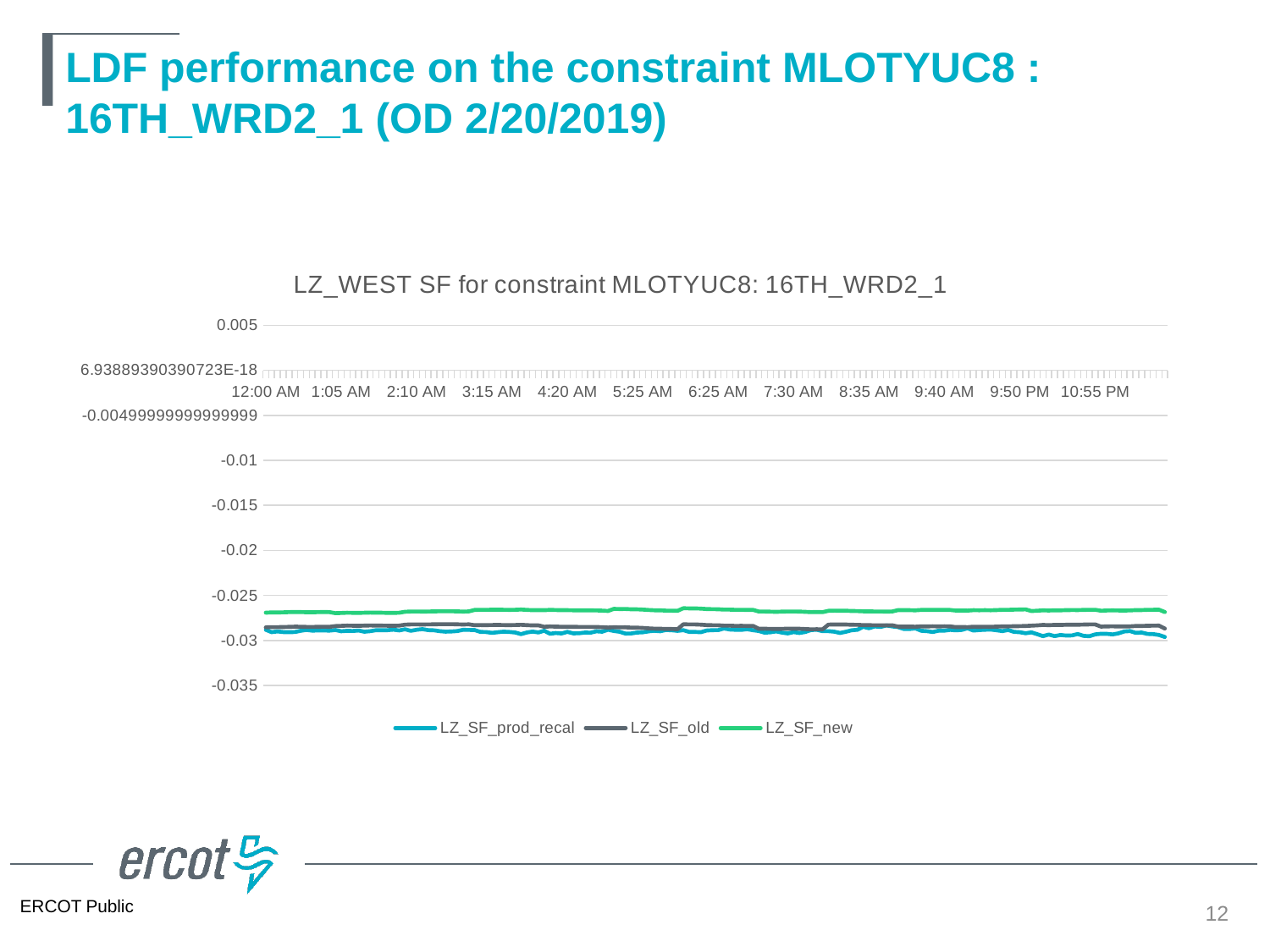
What is the first time label shown on the x axis? 12:00 AM Which series has larger values, LZ_SF_new or LZ_SF_prod_recal? LZ_SF_new What is the lowest value shown on the y axis? -0.035 What kind of chart is shown on the slide? line chart What is the title of the chart? LZ_WEST SF for constraint MLOTYUC8: 16TH_WRD2_1 Do the values of LZ_SF_new rise, fall, or stay roughly flat across the x axis? roughly flat How many series does the legend list? 3 Is the value for LZ_SF_new greater or less than -0.02? less Which series has the highest values across the chart? LZ_SF_new Is the value for LZ_SF_old greater or less than -0.025? less Is the value for LZ_SF_prod_recal greater or less than -0.035? greater